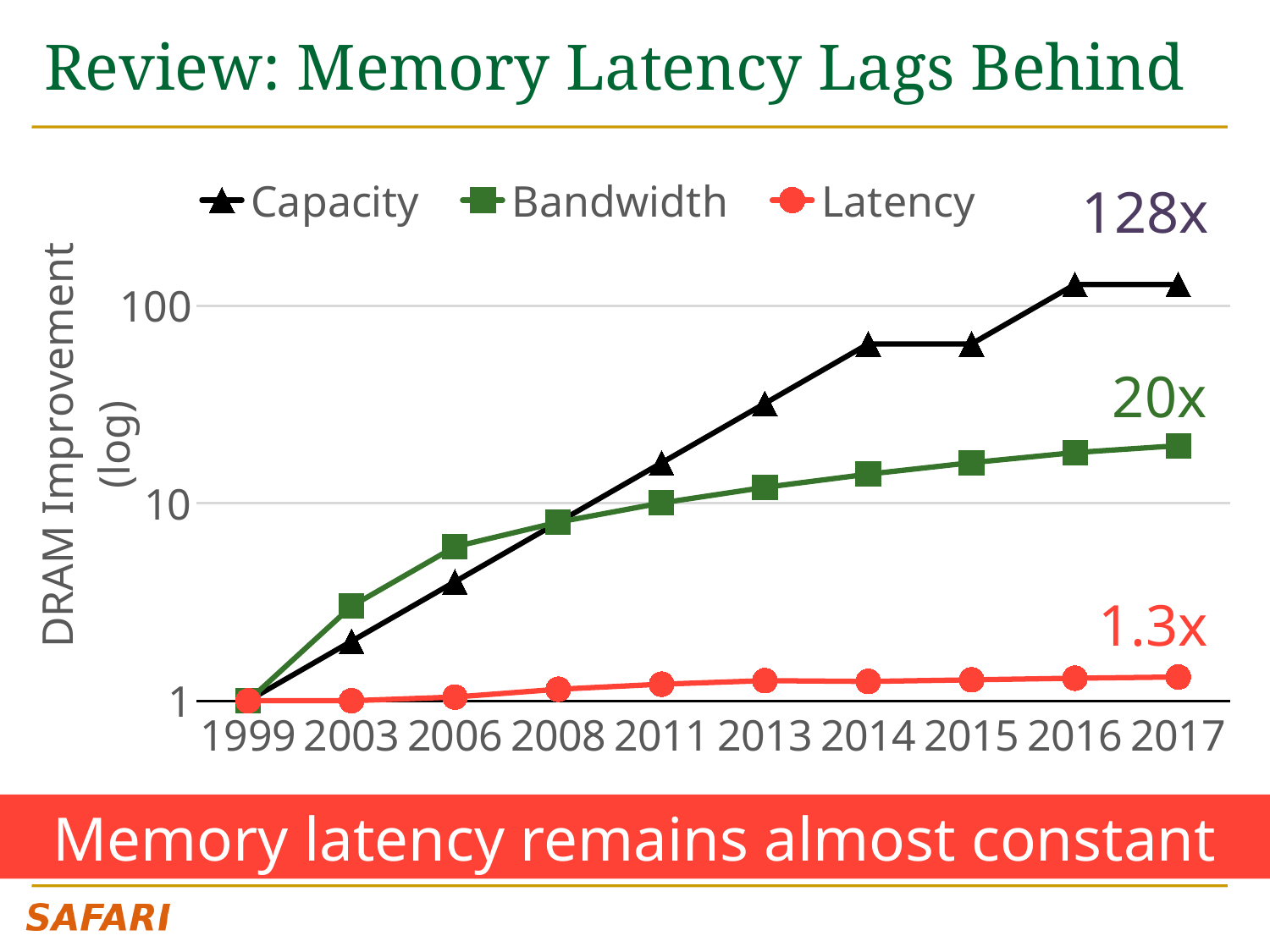
How many series does the legend list? 3 What is the label on the y axis? DRAM Improvement (log) Does the Capacity series rise or fall from 1999 to 2017? rise Which series has the lowest value in 2017? Latency What is the DRAM improvement for Bandwidth in 2017? 20x How many years are shown along the x axis? 10 What kind of chart is shown on the slide? line chart What is the DRAM improvement for Capacity in 2017? 128x What is the DRAM improvement for Latency in 2017? 1.3x Is the value for Capacity in 2016 greater or less than 100? greater Which series has the highest value in 2017? Capacity In 2006, which is larger: Capacity or Bandwidth? Bandwidth